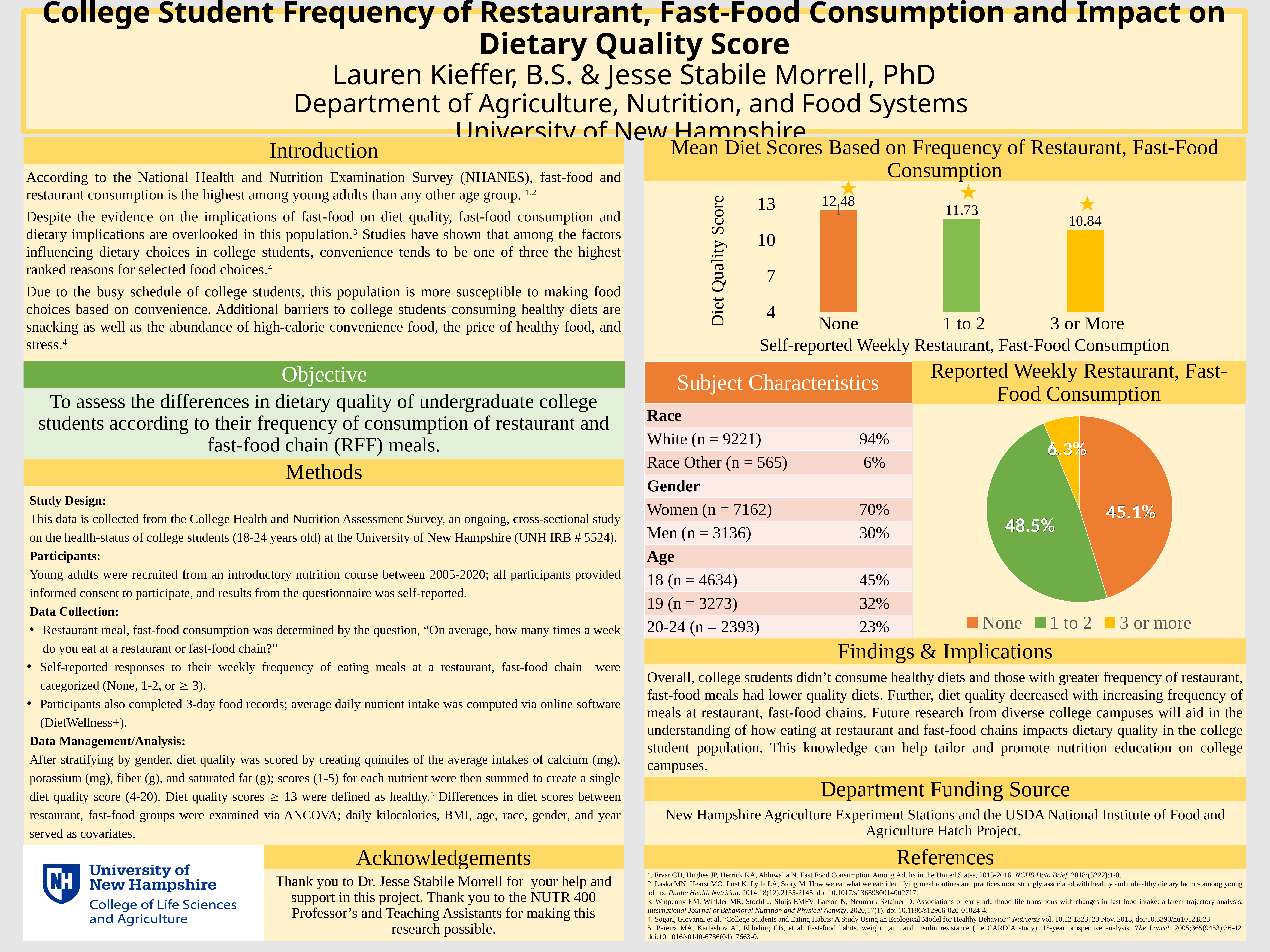
In the bar chart 'Mean Diet Scores Based on Frequency of Restaurant, Fast-Food Consumption', how many consumption groups are plotted? 3 In the pie chart 'Reported Weekly Restaurant, Fast-Food Consumption', which category is larger: 'None' or '1 to 2'? 1 to 2 How many categories does the legend of the pie chart 'Reported Weekly Restaurant, Fast-Food Consumption' list? 3 In the bar chart 'Mean Diet Scores Based on Frequency of Restaurant, Fast-Food Consumption', do the diet quality scores rise or fall as weekly consumption frequency increases along the x axis? fall In the pie chart 'Reported Weekly Restaurant, Fast-Food Consumption', what share of students reported '3 or more' weekly restaurant or fast-food meals? 6.3% What type of chart is 'Mean Diet Scores Based on Frequency of Restaurant, Fast-Food Consumption'? bar chart In the bar chart 'Mean Diet Scores Based on Frequency of Restaurant, Fast-Food Consumption', what is the difference between the diet quality scores of the 'None' and '1 to 2' groups? 0.75 In the bar chart 'Mean Diet Scores Based on Frequency of Restaurant, Fast-Food Consumption', which group has the lowest diet quality score? 3 or More In the pie chart 'Reported Weekly Restaurant, Fast-Food Consumption', what share of students reported '1 to 2' weekly restaurant or fast-food meals? 48.5% In the bar chart 'Mean Diet Scores Based on Frequency of Restaurant, Fast-Food Consumption', which group has the highest diet quality score? None In the bar chart 'Mean Diet Scores Based on Frequency of Restaurant, Fast-Food Consumption', what is the mean diet quality score for the 'None' group? 12.48 In the bar chart 'Mean Diet Scores Based on Frequency of Restaurant, Fast-Food Consumption', what is the mean diet quality score for the '3 or More' group? 10.84